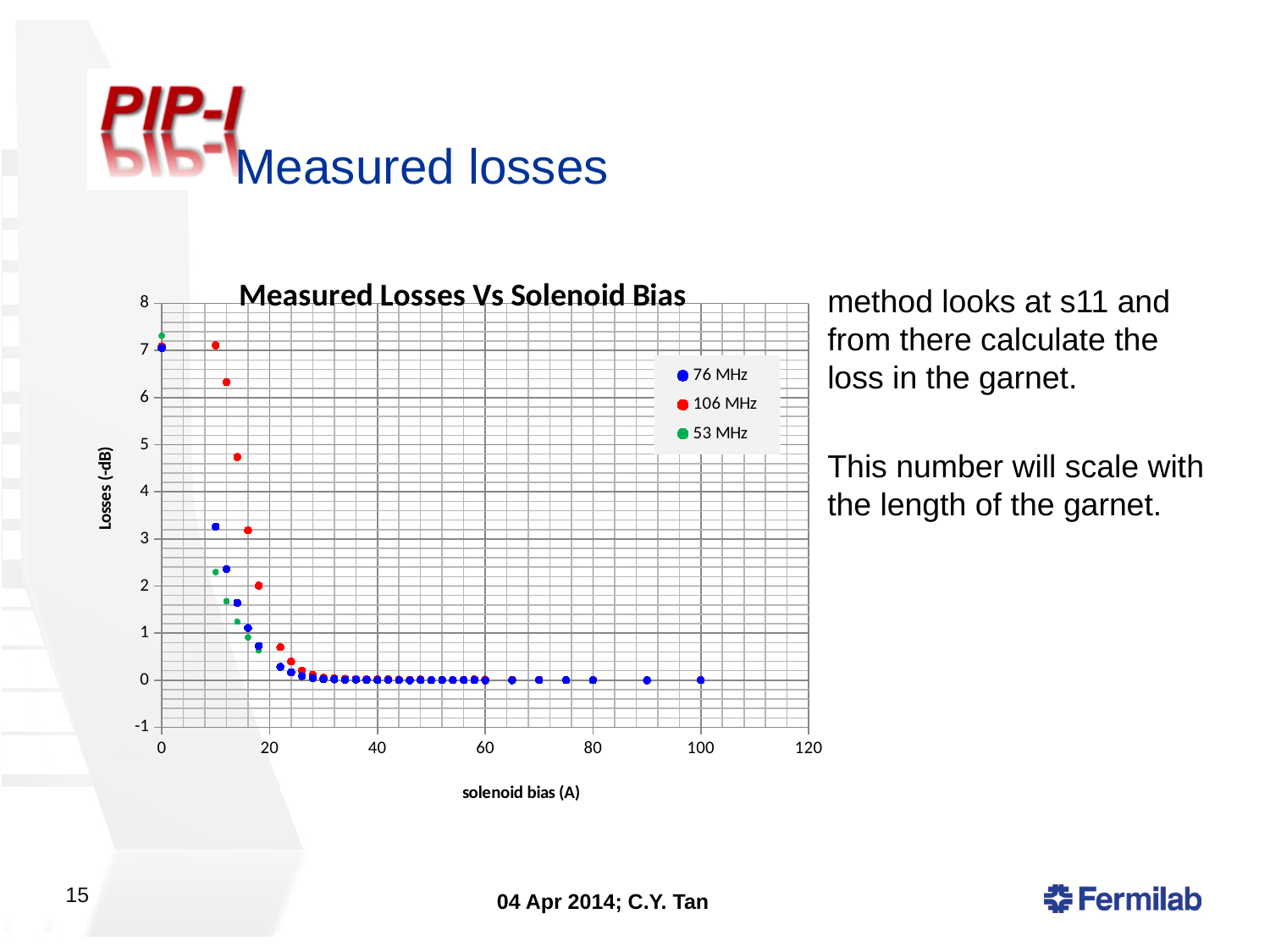
At a solenoid bias of 10 A, which is larger: the loss for 76 MHz or the loss for 53 MHz? 76 MHz Do the losses rise or fall as the solenoid bias increases along the x axis? fall What kind of chart is shown on the slide? scatter chart What is the title of the chart? Measured Losses Vs Solenoid Bias At a solenoid bias of 10 A, which series shows the highest loss? 106 MHz How many series does the legend of the chart list? 3 Is the loss for the 106 MHz series at a solenoid bias of 10 A greater or less than 6? greater What is the label of the x axis of the chart? solenoid bias (A) What is the highest value shown on the x axis of the chart? 120 Is the loss for the 76 MHz series at a solenoid bias of 10 A greater or less than 4? less